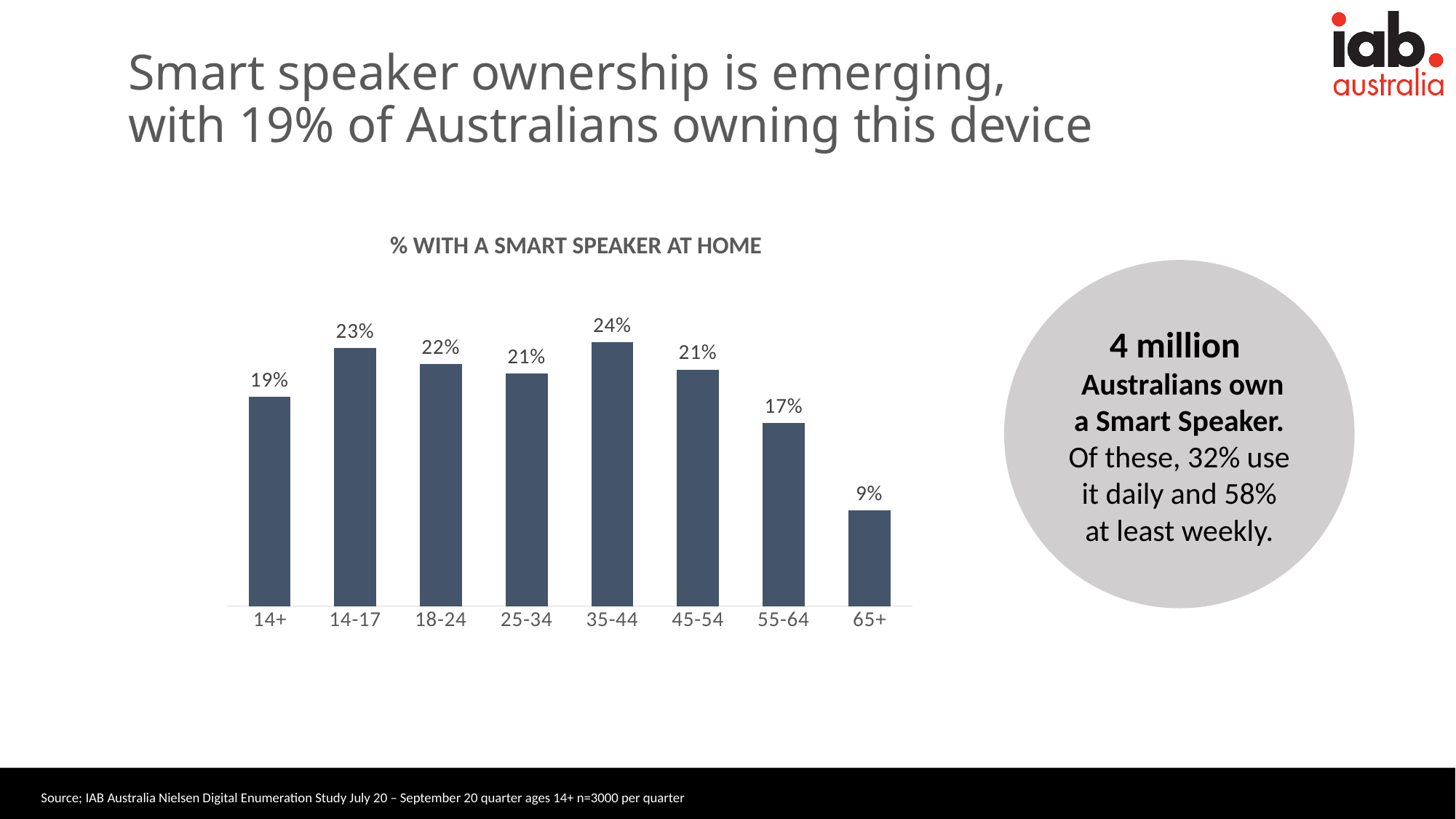
What percentage of the 65+ age group has a smart speaker at home? 9% What is the value shown for the 35-44 age group? 24% How many age categories are shown on the x axis of the chart? 8 Which age group has the lowest percentage with a smart speaker at home? 65+ What type of chart is shown on the slide? Bar chart Which age group has the highest percentage with a smart speaker at home? 35-44 What is the difference between the values for the 14-17 and 65+ age groups? 14% What is the value shown for the 55-64 age group? 17% What is the title of the chart? % WITH A SMART SPEAKER AT HOME Which has a higher value, the 18-24 group or the 55-64 group? 18-24 What percentage of the 14+ group has a smart speaker at home? 19% What is the difference between the values for the 35-44 and 55-64 age groups? 7%